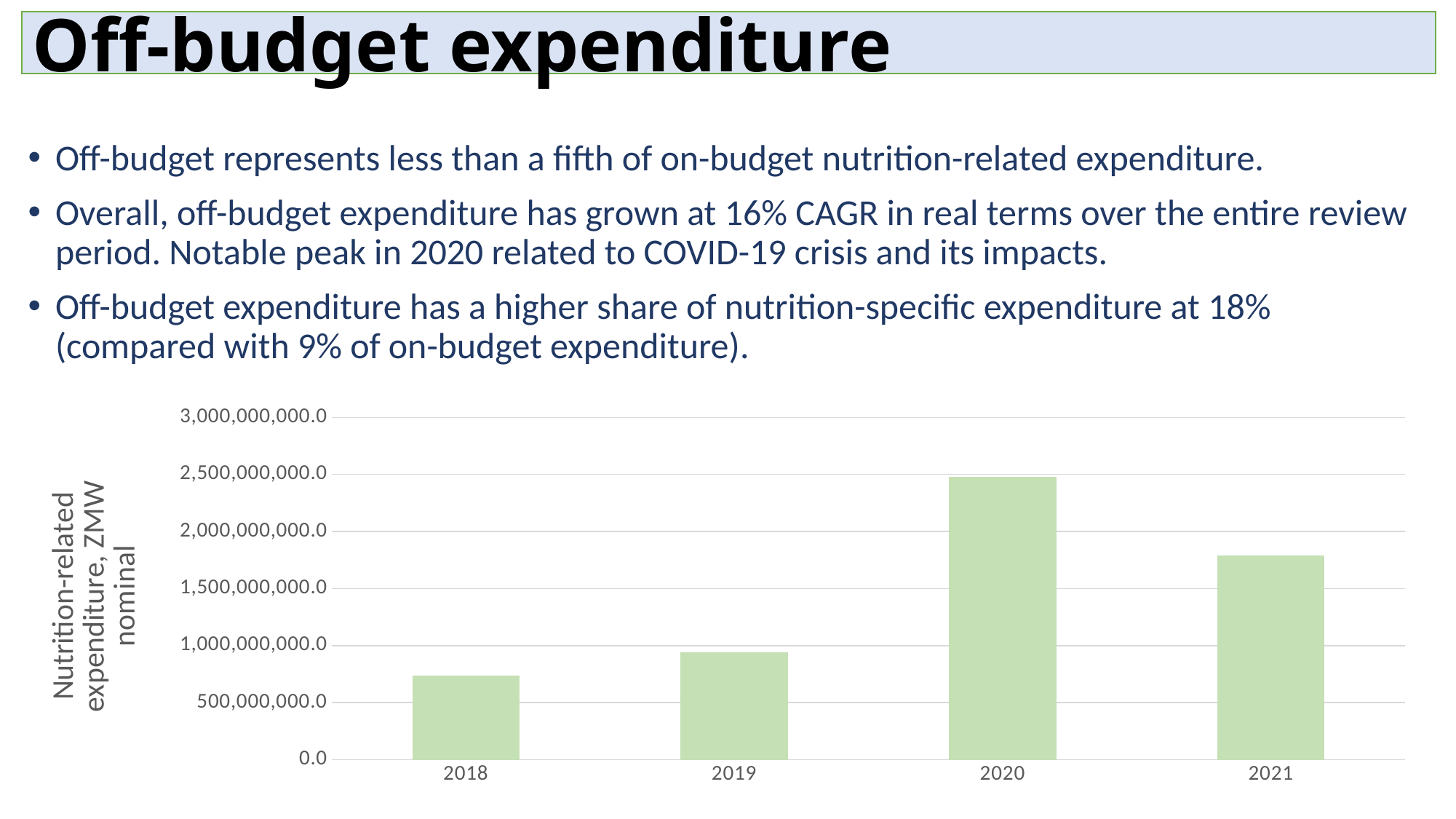
Is the value for 2021 greater or less than 2,000,000,000.0? less Which year has the lowest nutrition-related expenditure in the chart? 2018 How does the expenditure change from 2018 to 2020 in the chart? It rises Is the value for 2021 greater or less than 1,500,000,000.0? greater Is the value for 2020 greater or less than 2,000,000,000.0? greater How many years are plotted on the x axis of the chart? 4 Which year has the highest nutrition-related expenditure in the chart? 2020 Which year has the larger expenditure, 2019 or 2021? 2021 What is the label on the y axis of the chart? Nutrition-related expenditure, ZMW nominal What kind of chart is shown on the slide? Bar chart